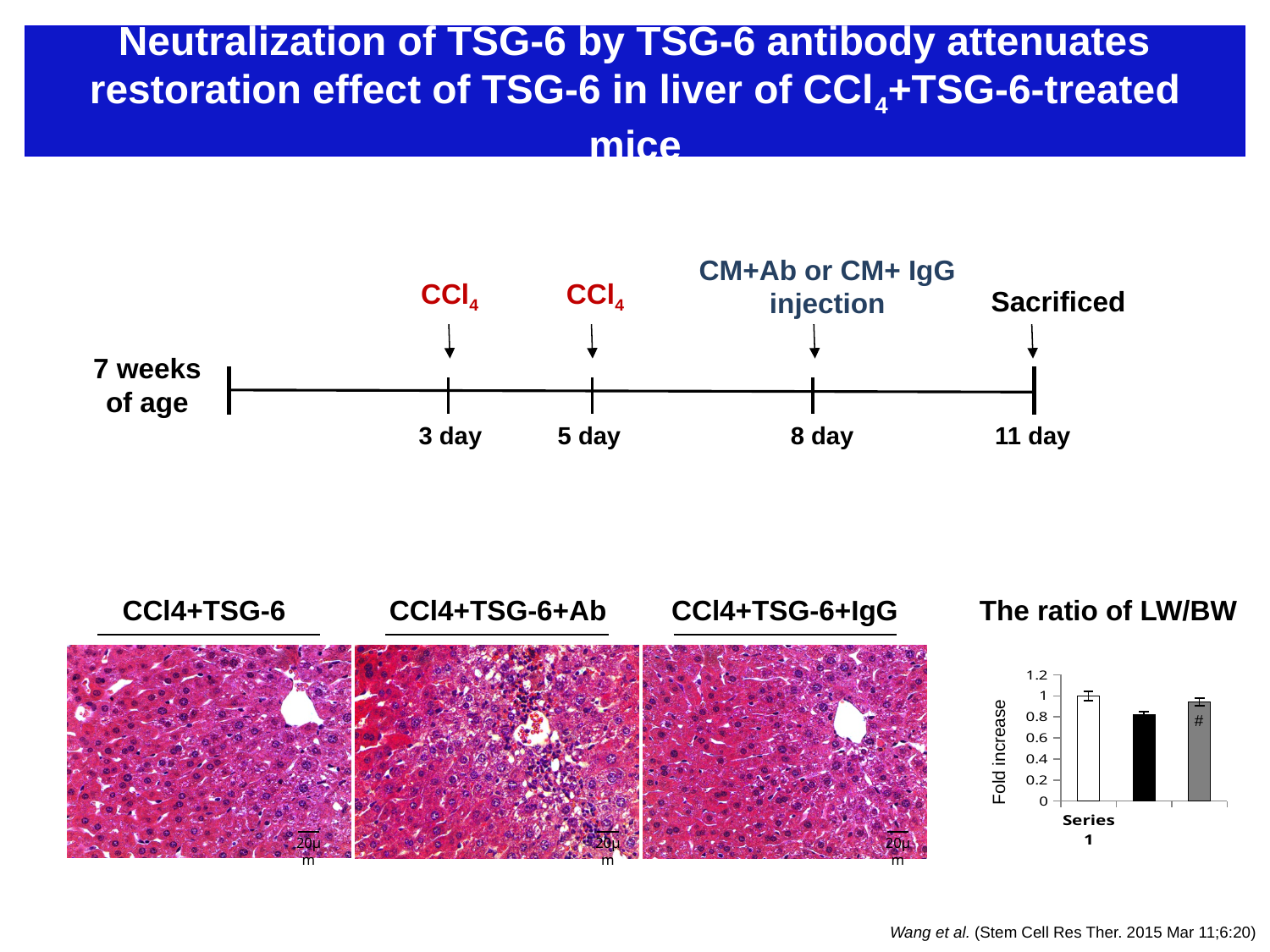
What is the maximum value shown on the y-axis of 'The ratio of LW/BW' chart? 1.2 How many bars are plotted in 'The ratio of LW/BW' chart? 3 In 'The ratio of LW/BW' chart, is the value of the gray (right) bar greater or less than 0.8? greater In 'The ratio of LW/BW' chart, which bar is the lowest? the black (middle) bar What kind of chart is 'The ratio of LW/BW'? bar chart In 'The ratio of LW/BW' chart, which is larger, the gray (right) bar or the black (middle) bar? the gray (right) bar What is the y-axis title of 'The ratio of LW/BW' chart? Fold increase In 'The ratio of LW/BW' chart, is the value of the black (middle) bar greater or less than 0.6? greater In 'The ratio of LW/BW' chart, is the value of the white (left) bar greater or less than 0.8? greater In 'The ratio of LW/BW' chart, which is larger, the white (left) bar or the black (middle) bar? the white (left) bar